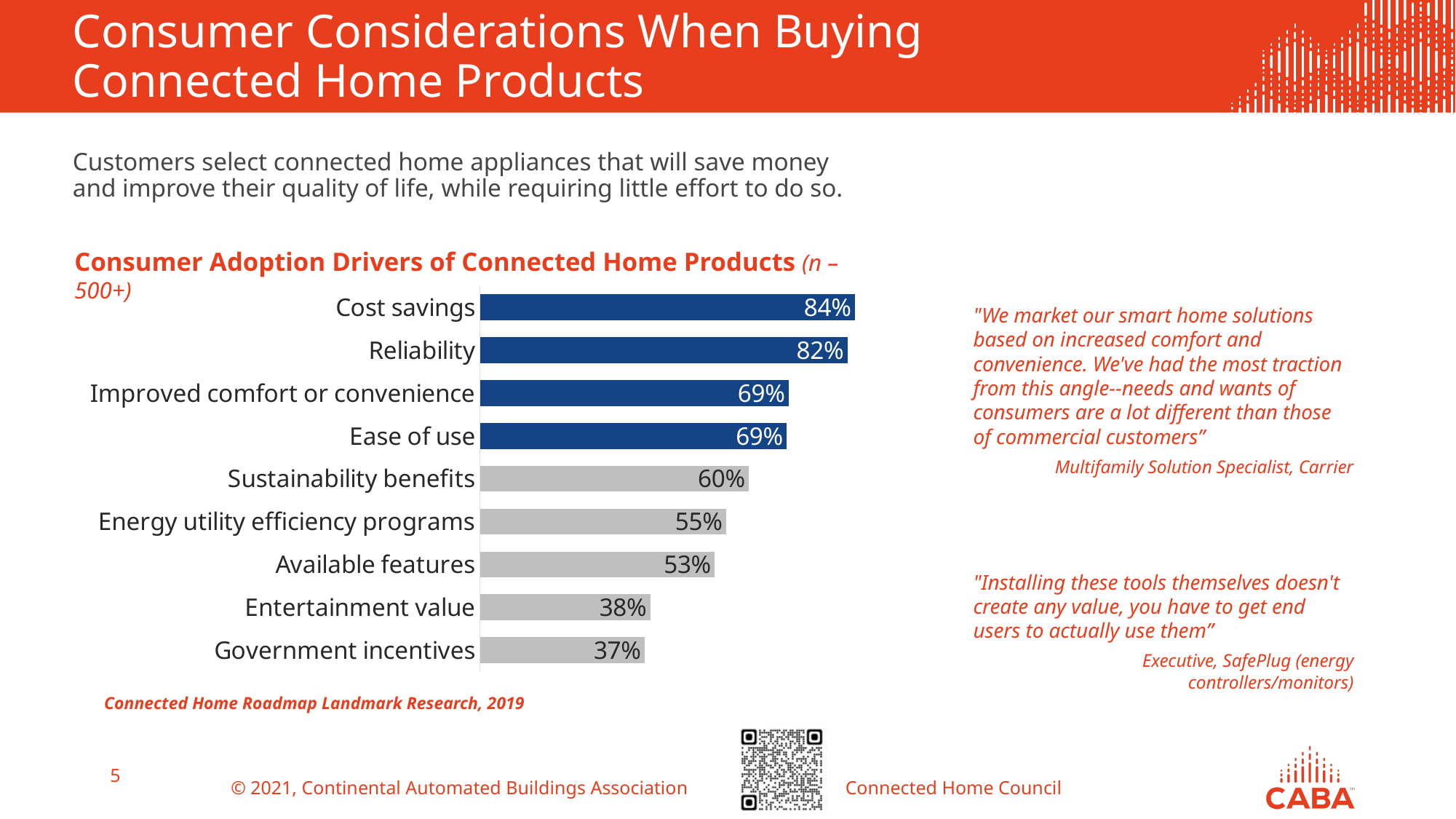
What is the value for Cost savings? 84% Which is larger, the value for Available features or the value for Entertainment value? Available features What kind of chart is shown on the slide? Bar chart Which category has the highest value? Cost savings Which category has the lowest value? Government incentives What is the value for Energy utility efficiency programs? 55% What is the value for Government incentives? 37% What is the difference between the values for Cost savings and Reliability? 2% How many categories are shown in the chart? 9 How many bars in the chart are coloured dark blue? 4 What is the title of the chart? Consumer Adoption Drivers of Connected Home Products What is the difference between the values for Sustainability benefits and Entertainment value? 22%